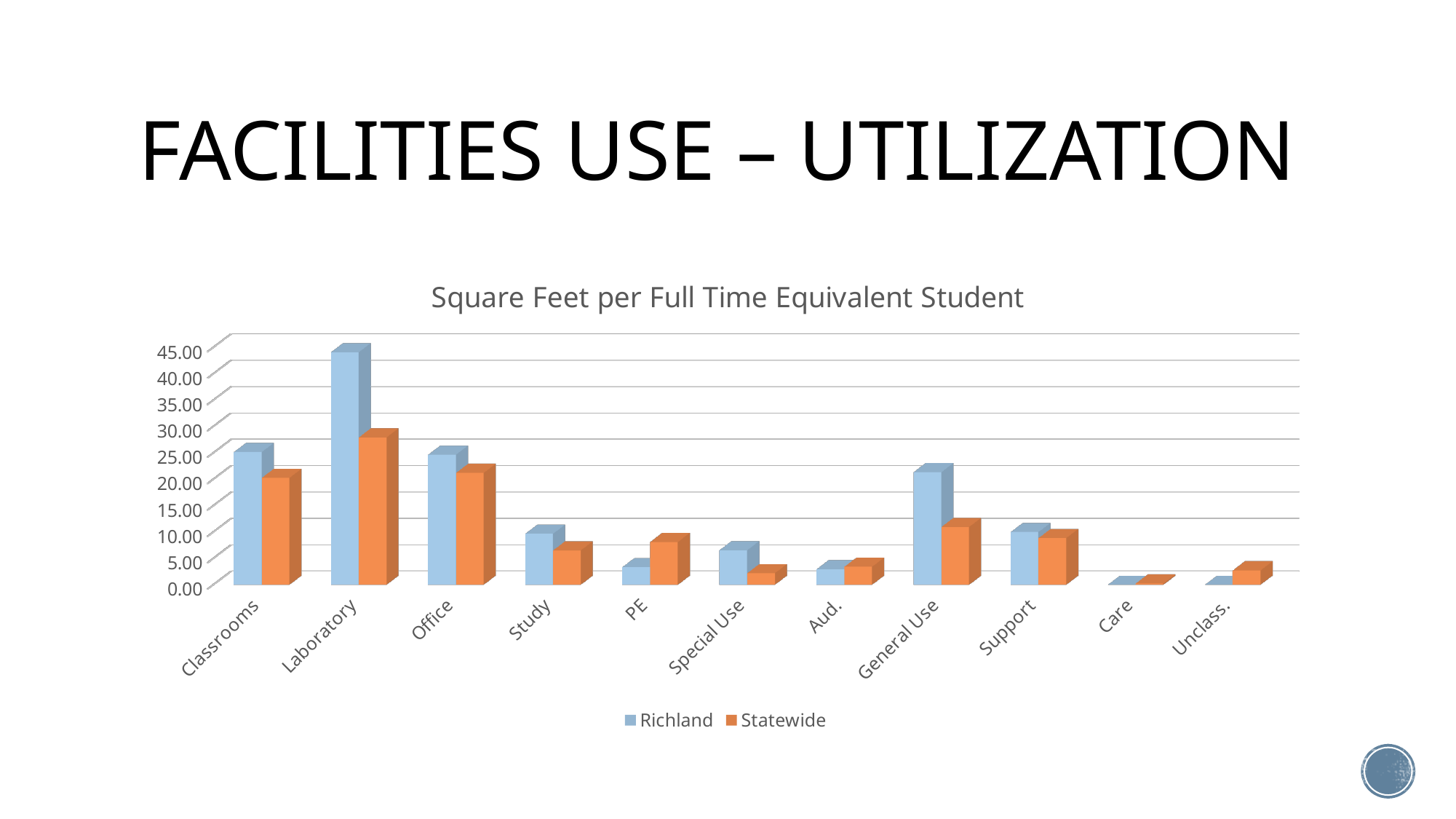
Is the Richland value for Classrooms greater or less than 20.00? greater For Classrooms, which series has the larger value, Richland or Statewide? Richland What kind of chart is shown on the slide? bar chart What is the title of the chart? Square Feet per Full Time Equivalent Student How many series does the legend list? 2 Is the Richland value for Laboratory greater or less than 40.00? greater How many categories are shown on the x axis? 11 For PE, which series has the larger value, Richland or Statewide? Statewide Which category has the highest Statewide value? Laboratory Is the Richland value for General Use greater or less than 15.00? greater Which category has the highest Richland value? Laboratory